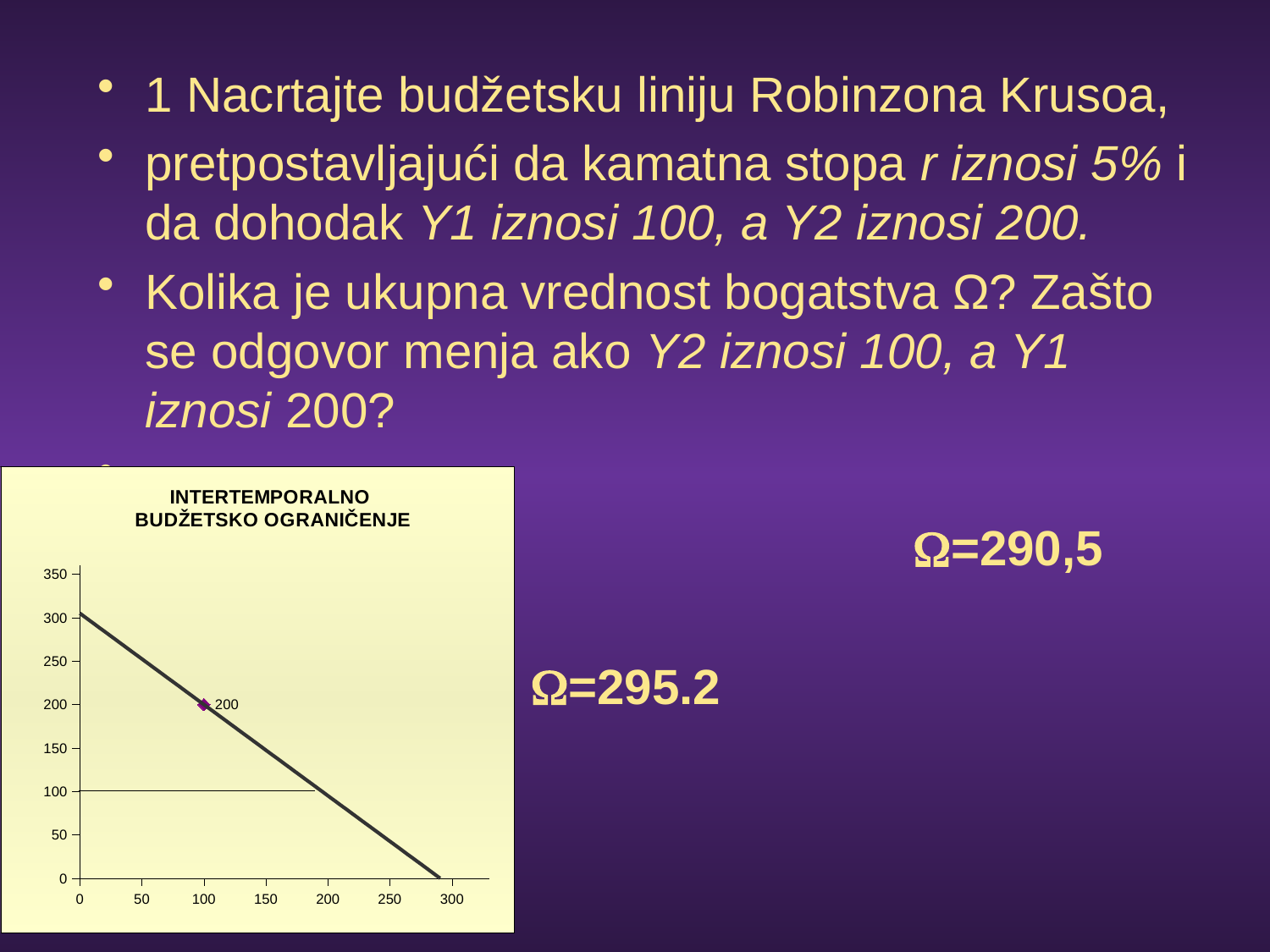
Is the value of the line at x = 150 greater or less than 200? less What is the highest value shown on the vertical axis? 350 Is the value of the line at x = 250 greater or less than 100? less At which x-axis value is the labelled point on the line located? 100 Does the line rise or fall as the x-axis value increases? fall Is the value of the line at x = 50 greater or less than 200? greater How many tick labels are shown on the horizontal axis? 7 What value is printed as the data label on the marked point of the line? 200 What is the title of the chart? INTERTEMPORALNO BUDŽETSKO OGRANIČENJE What kind of chart is shown on the slide? line chart